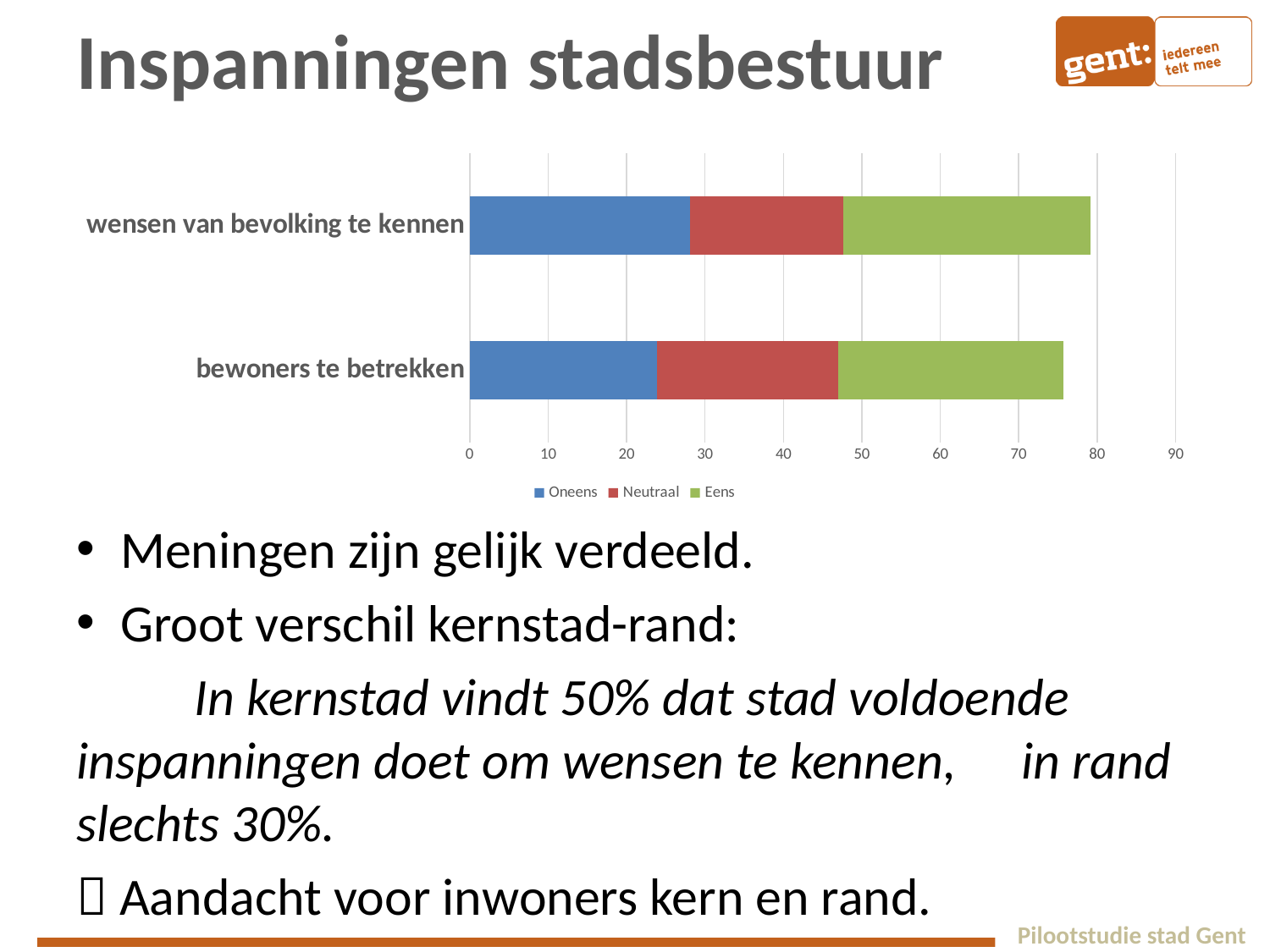
How many series does the chart legend list? 3 Is the 'Oneens' value for 'wensen van bevolking te kennen' greater or less than 30? less What kind of chart is shown on the slide? bar chart Is the 'Oneens' value for 'bewoners te betrekken' greater or less than 20? greater Is the total length of the stacked bar for 'bewoners te betrekken' greater or less than 80? less Which colour represents the 'Eens' series in the chart? green What are the series names listed in the chart legend? Oneens, Neutraal, Eens How many categories are plotted in the chart? 2 Which category has the larger 'Neutraal' value: 'wensen van bevolking te kennen' or 'bewoners te betrekken'? bewoners te betrekken Which category has the larger 'Oneens' value: 'wensen van bevolking te kennen' or 'bewoners te betrekken'? wensen van bevolking te kennen